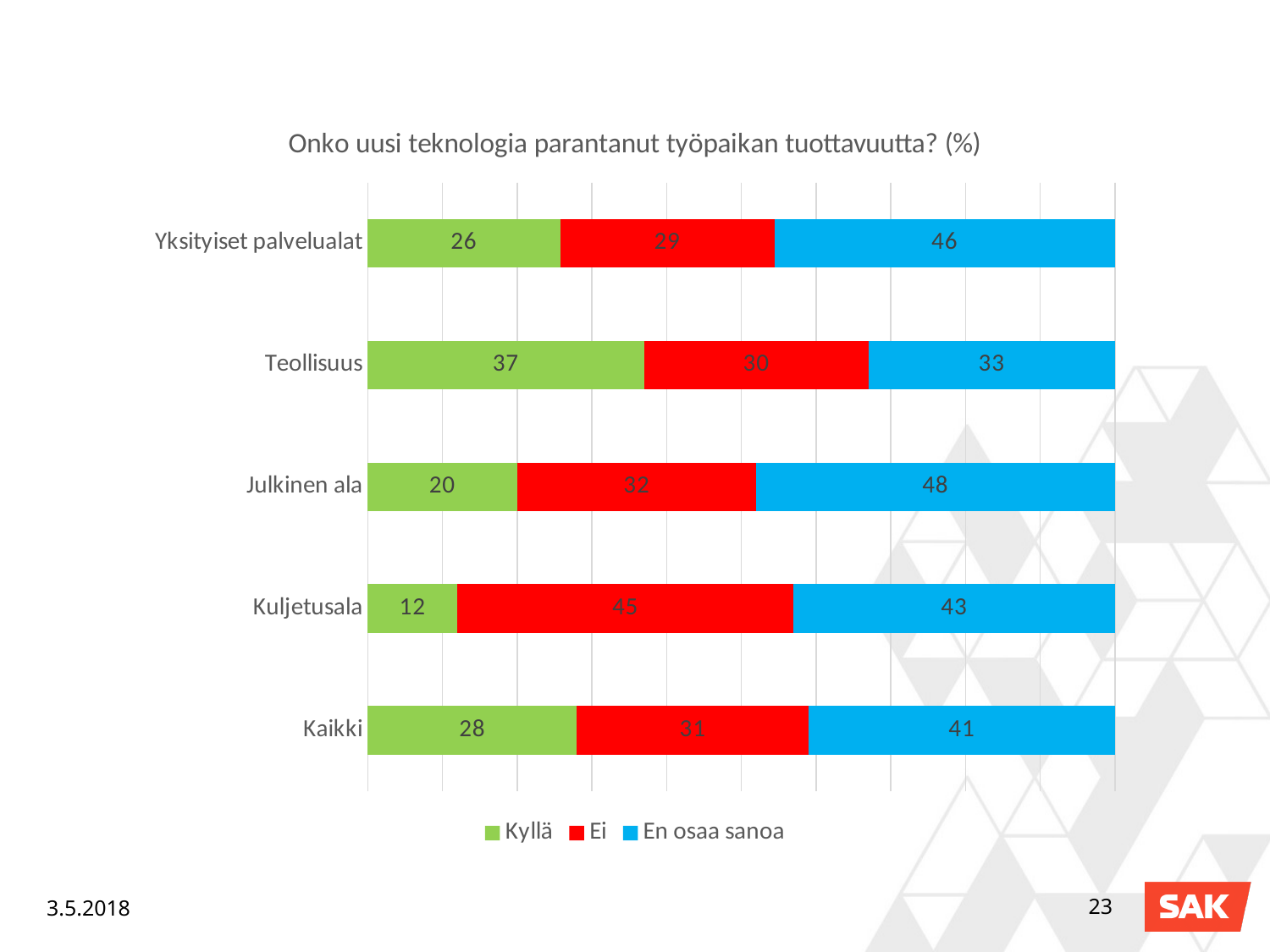
How many categories are shown on the chart? 5 What is the title of the chart? Onko uusi teknologia parantanut työpaikan tuottavuutta? (%) What is the value of "En osaa sanoa" for Julkinen ala? 48 What is the value of "Ei" for Kuljetusala? 45 Which category has the highest "Kyllä" value? Teollisuus What is the value of "Kyllä" for Teollisuus? 37 How many series does the legend list? 3 What kind of chart is shown on the slide? Stacked bar chart Which category has the lowest "Kyllä" value? Kuljetusala What is the difference between the "Ei" value for Kuljetusala and the "Ei" value for Yksityiset palvelualat? 16 What is the total of the stacked bar for Kaikki? 100 Which is larger: the "En osaa sanoa" value for Yksityiset palvelualat or for Kaikki? Yksityiset palvelualat